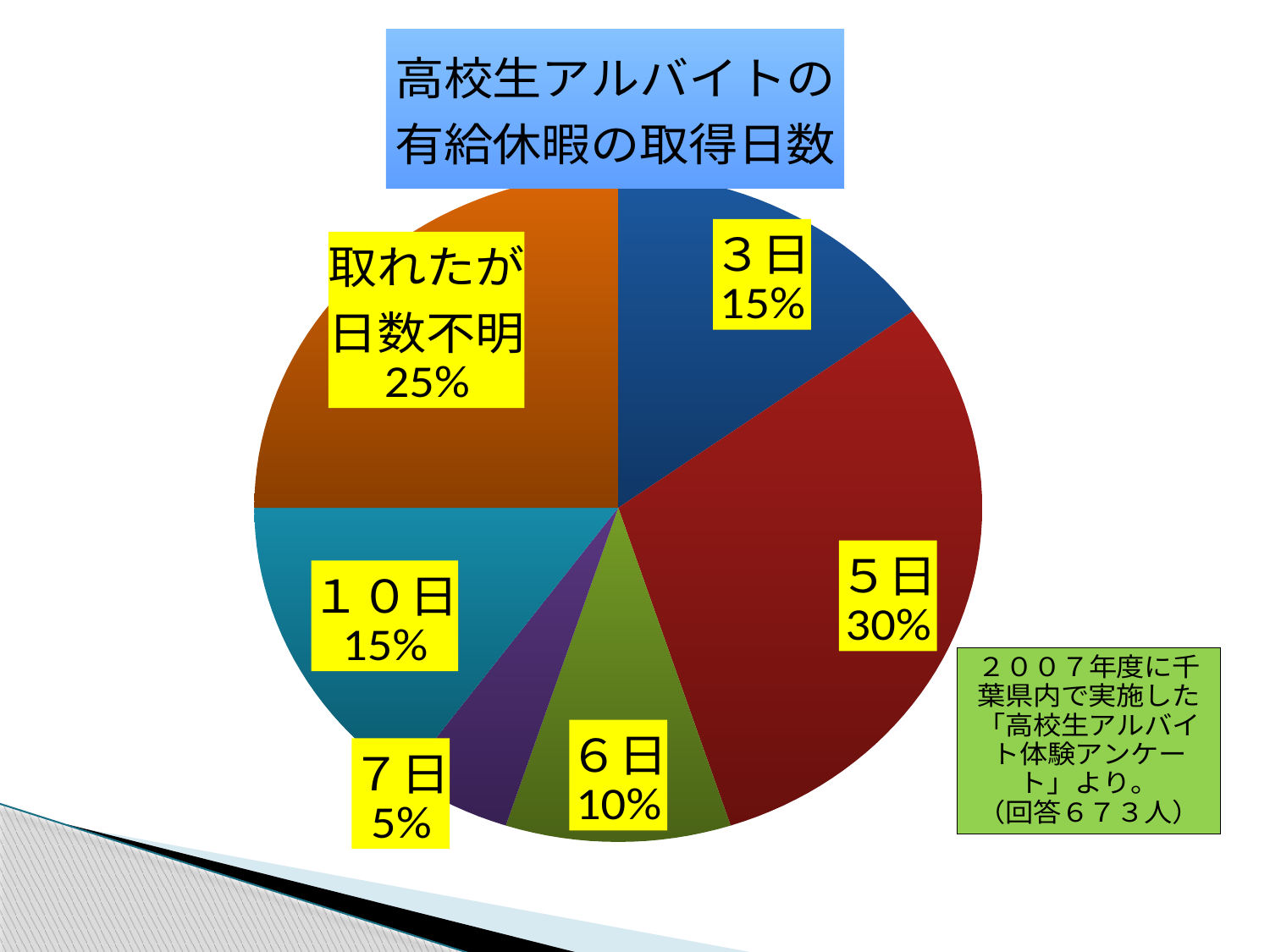
What is the difference between the shares for 5日 and 10日? 15% Which is larger, the share for 6日 or the share for 3日? 3日 Which category has the smallest slice of the pie? 7日 What is the title of the chart? 高校生アルバイトの有給休暇の取得日数 How many slices does the pie chart have? 6 What is the combined share of 3日 and 10日? 30% What share of the pie does 5日 represent? 30% What is the value shown for 7日? 5% Which category has the largest slice of the pie? 5日 What share of the pie does 取れたが日数不明 represent? 25% What kind of chart is shown on the slide? pie chart What is the value shown for 6日? 10%